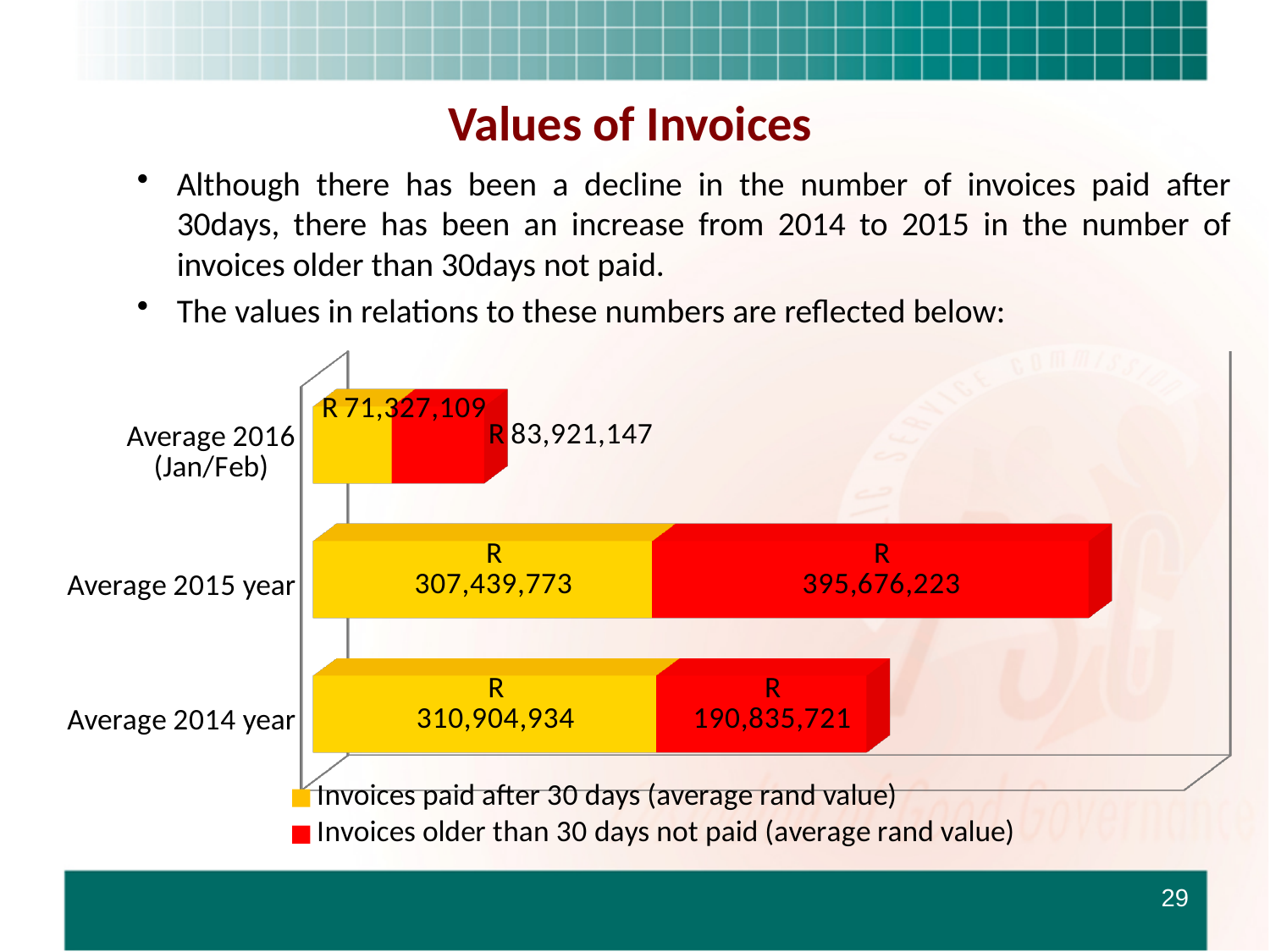
What is the difference between the value of invoices older than 30 days not paid in Average 2015 year and Average 2014 year? R 204,840,502 Which period has the lowest value of invoices paid after 30 days? Average 2016 (Jan/Feb) What is the value of invoices paid after 30 days for Average 2016 (Jan/Feb)? R 71,327,109 What is the value of invoices paid after 30 days for Average 2015 year? R 307,439,773 How many periods (categories) are shown in the chart? 3 What is the value of invoices older than 30 days not paid for Average 2016 (Jan/Feb)? R 83,921,147 What kind of chart is shown on the slide? Stacked bar chart How many series does the legend list? 2 What is the value of invoices older than 30 days not paid for Average 2014 year? R 190,835,721 Which is larger for Average 2014 year: invoices paid after 30 days or invoices older than 30 days not paid? Invoices paid after 30 days What is the total value of the stacked bar for Average 2014 year? R 501,740,655 Which period has the highest value of invoices older than 30 days not paid? Average 2015 year